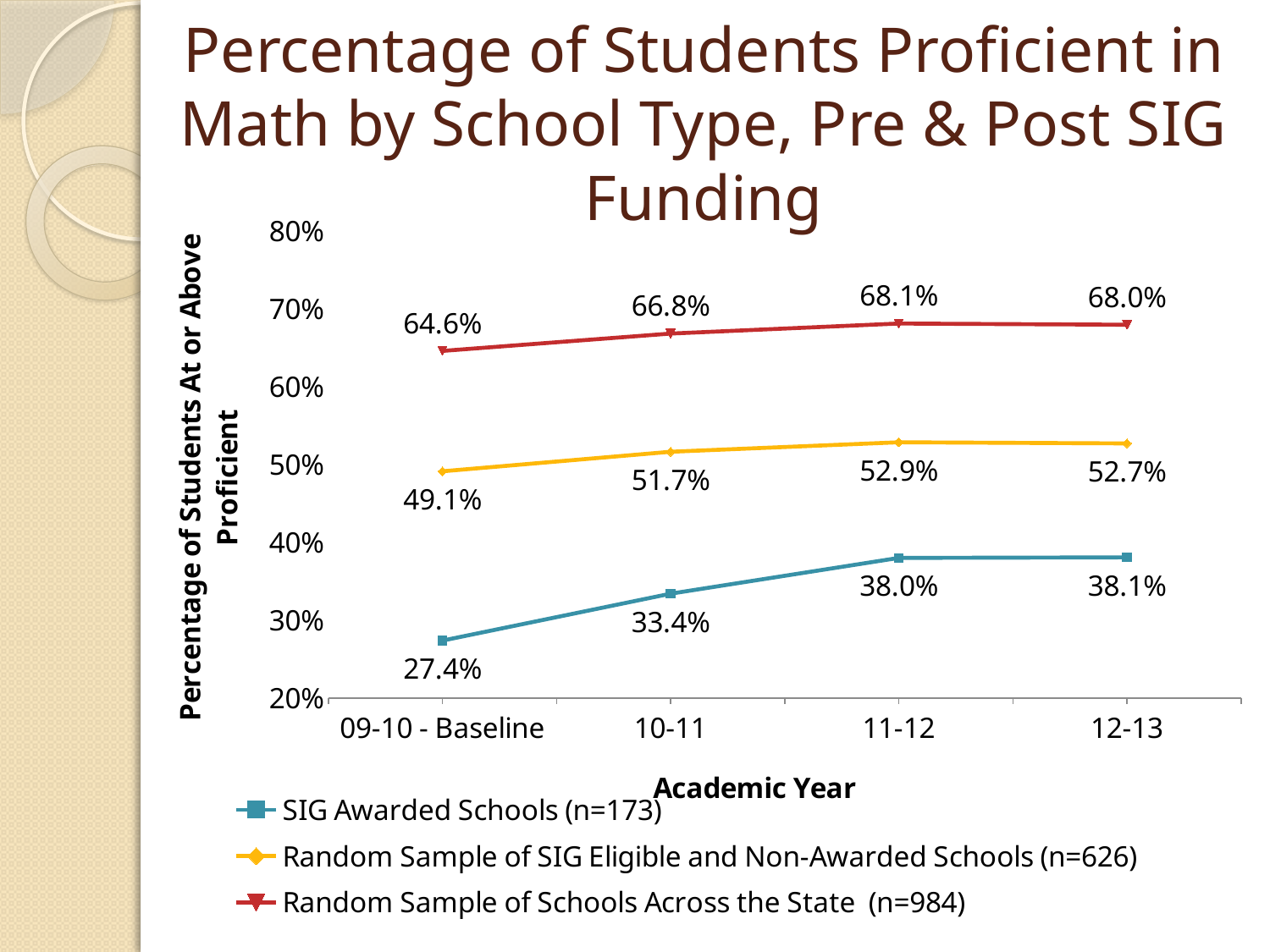
Which series had the highest percentage of students proficient in math in 12-13? Random Sample of Schools Across the State (n=984) What was the value for the Random Sample of SIG Eligible and Non-Awarded Schools in 10-11? 51.7% What is the difference between the SIG Awarded Schools value in 12-13 and in 09-10 - Baseline? 10.7 percentage points What kind of chart is shown on the slide? Line chart How many academic years are shown on the x axis? 4 Is the value for SIG Awarded Schools in 10-11 greater or less than 40%? less Which is larger: the Random Sample of Schools Across the State value in 10-11 or the Random Sample of SIG Eligible and Non-Awarded Schools value in 10-11? Random Sample of Schools Across the State Did the percentage for SIG Awarded Schools rise or fall from 09-10 - Baseline to 11-12? Rise In which academic year did SIG Awarded Schools have their lowest percentage of students proficient in math? 09-10 - Baseline What percentage of students were proficient in math at SIG Awarded Schools in 09-10 - Baseline? 27.4% How many series does the legend list? 3 What was the value for the Random Sample of Schools Across the State in 11-12? 68.1%